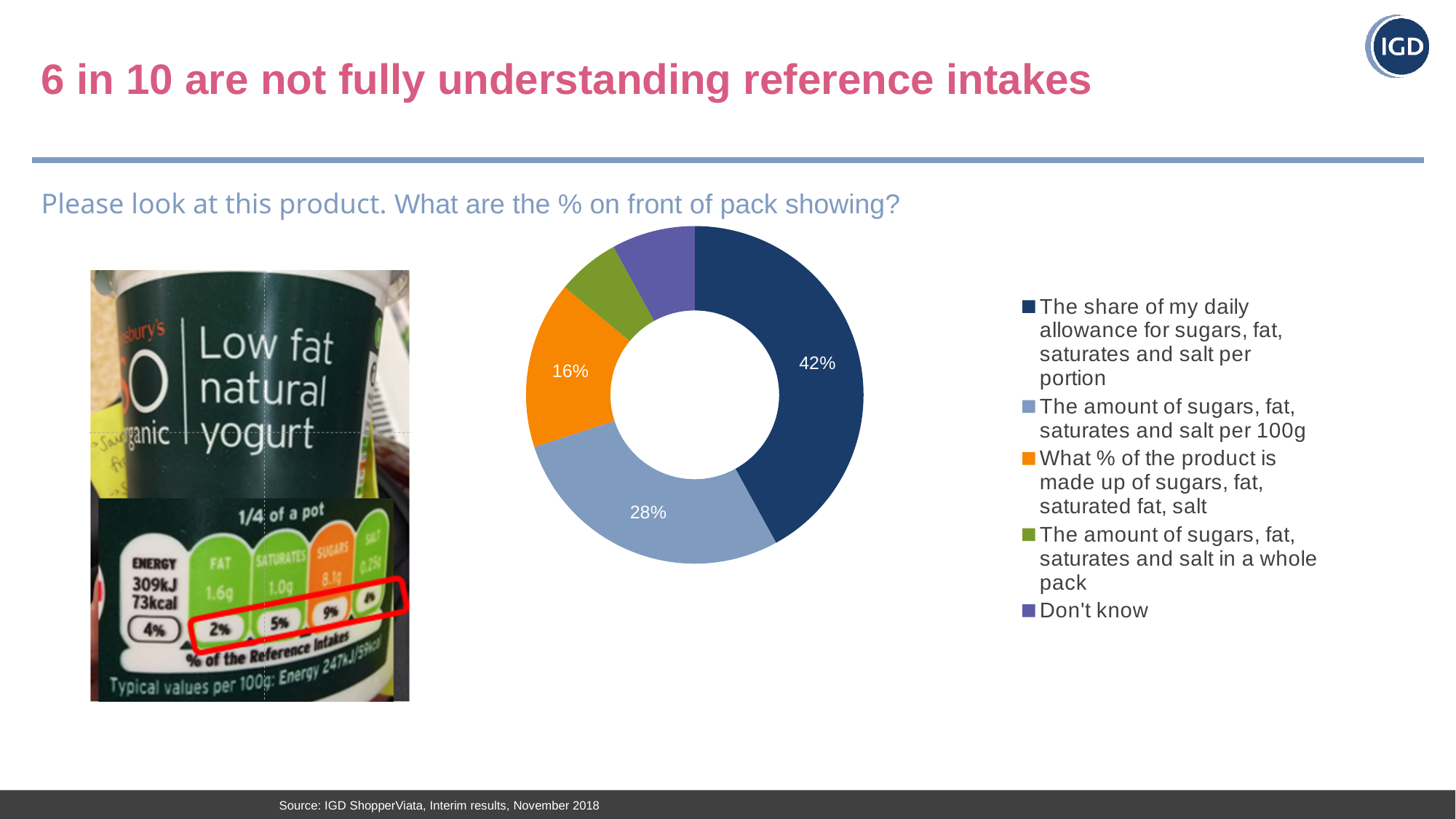
What kind of chart is shown on the slide? Pie (donut) chart How many response categories does the pie chart show? 5 What colour is the slice representing 'Don't know'? Purple Which is larger: the share for 'The amount of sugars, fat, saturates and salt per 100g' or for 'What % of the product is made up of sugars, fat, saturated fat, salt'? The amount of sugars, fat, saturates and salt per 100g What is the difference in percentage points between the 'per portion' response and the 'per 100g' response? 14 percentage points What is the difference in percentage points between the 'per 100g' response and the 'what % of the product is made up of' response? 12 percentage points What percentage of respondents said the % show the amount of sugars, fat, saturates and salt per 100g? 28% How many entries does the chart legend list? 5 What percentage of respondents said the % on front of pack show the share of their daily allowance for sugars, fat, saturates and salt per portion? 42% What percentage of respondents said the % show what % of the product is made up of sugars, fat, saturated fat, salt? 16% Which response has the largest share of the pie chart? The share of my daily allowance for sugars, fat, saturates and salt per portion What survey question does the chart relate to? Please look at this product. What are the % on front of pack showing?